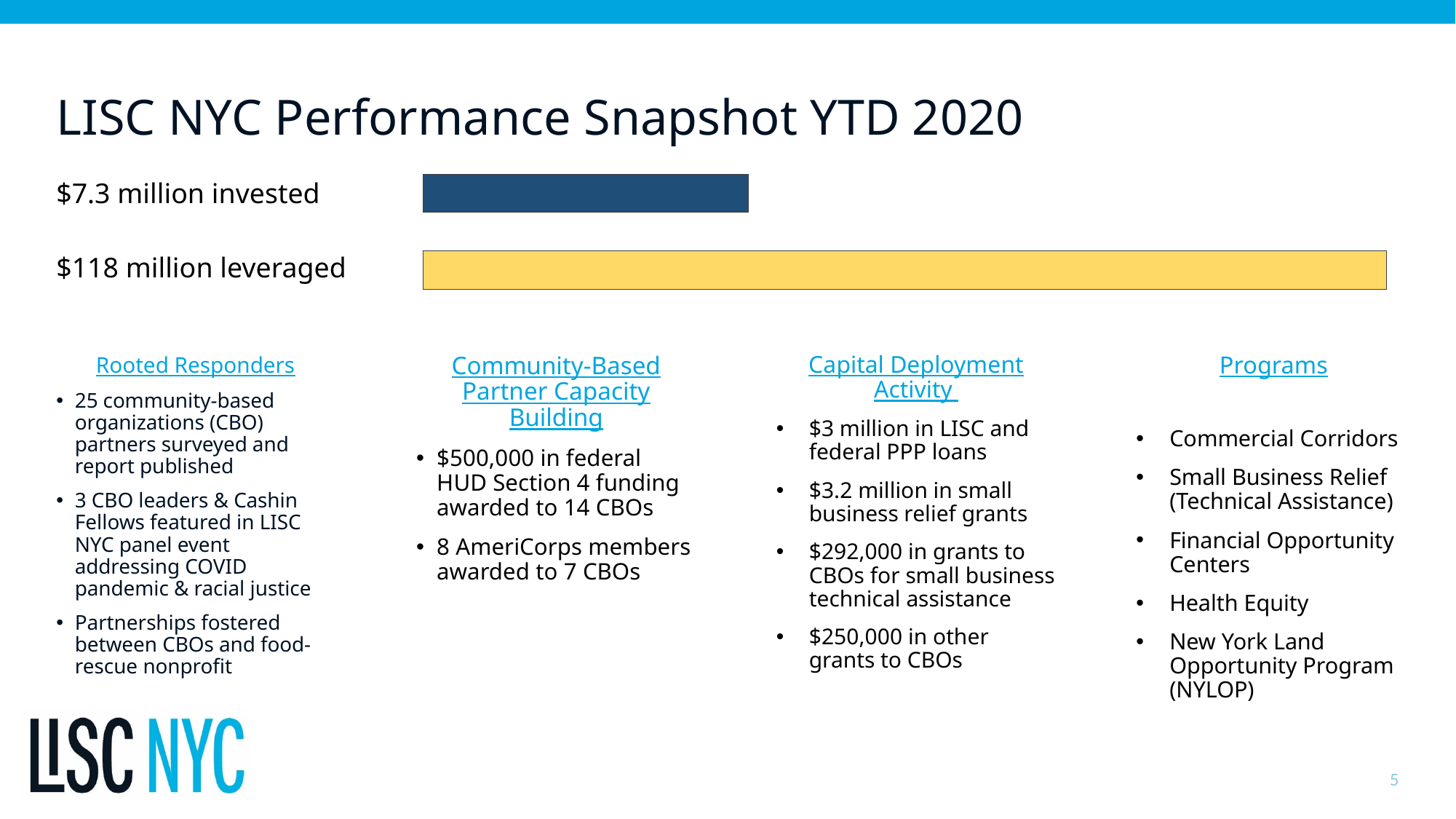
Is the amount leveraged larger or smaller than the amount invested? larger What kind of chart is shown on the slide? bar chart What value is shown for the amount invested? $7.3 million How many bars are shown in the chart? 2 Which bar represents the smaller amount, invested or leveraged? invested What value is shown for the amount leveraged? $118 million What colour is the bar for the amount invested? dark blue What colour is the bar for the amount leveraged? yellow Which bar represents the larger amount, invested or leveraged? leveraged What is the difference between the amount leveraged and the amount invested? $110.7 million